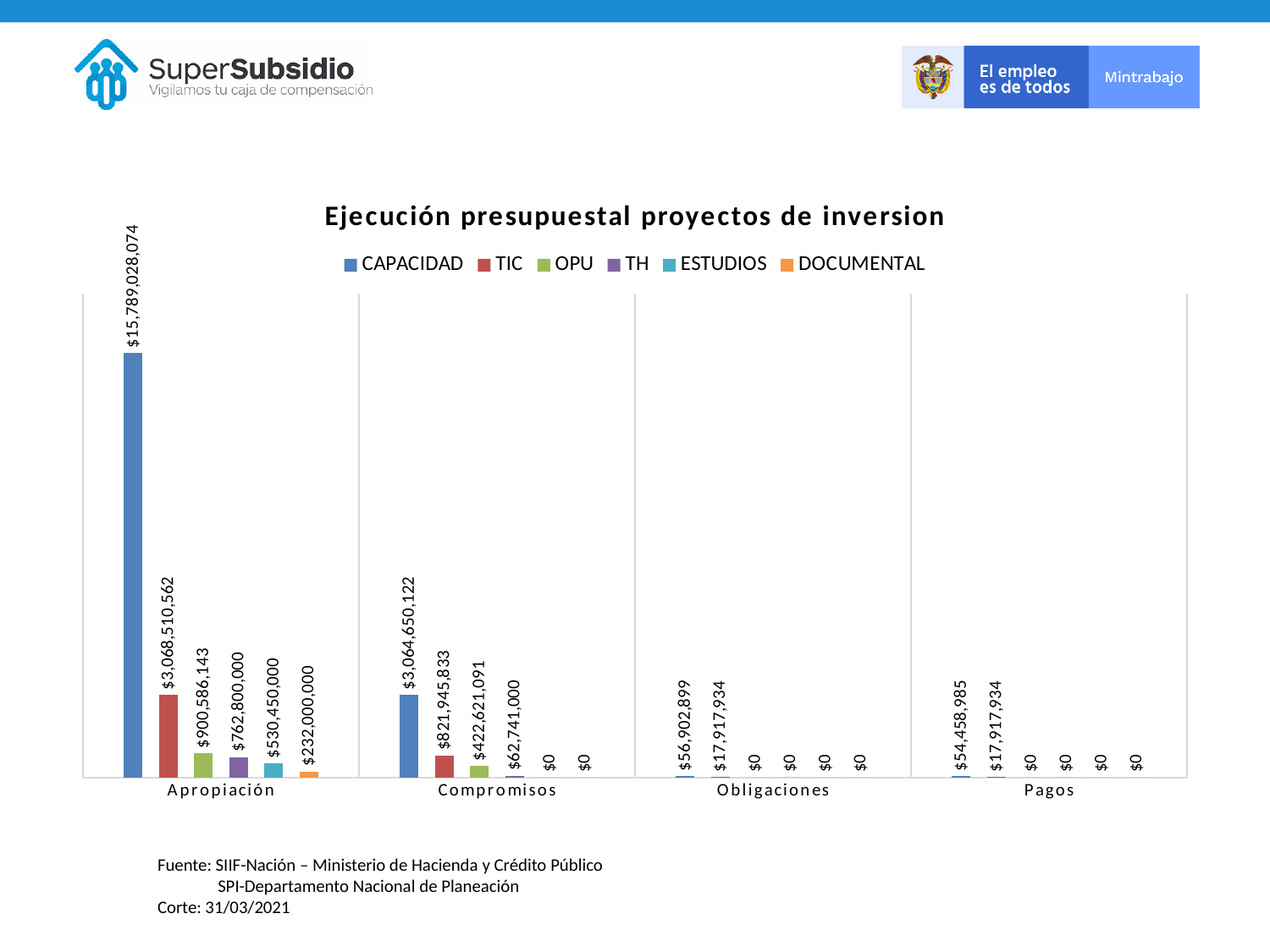
What is the value for DOCUMENTAL in the Apropiación category? $232,000,000 Which series has the highest value in the Apropiación category? CAPACIDAD What is the value for CAPACIDAD in the Apropiación category? $15,789,028,074 Which series has the lowest value in the Apropiación category? DOCUMENTAL Which is larger in the Apropiación category: TH or ESTUDIOS? TH How many series does the legend list? 6 What is the value for TIC in the Compromisos category? $821,945,833 What is the value for TH in the Compromisos category? $62,741,000 What is the difference between the CAPACIDAD and TIC values in the Apropiación category? $12,720,517,512 How many categories are shown on the x axis? 4 Does the CAPACIDAD value rise or fall from Apropiación to Pagos? fall What is the value for CAPACIDAD in the Pagos category? $54,458,985